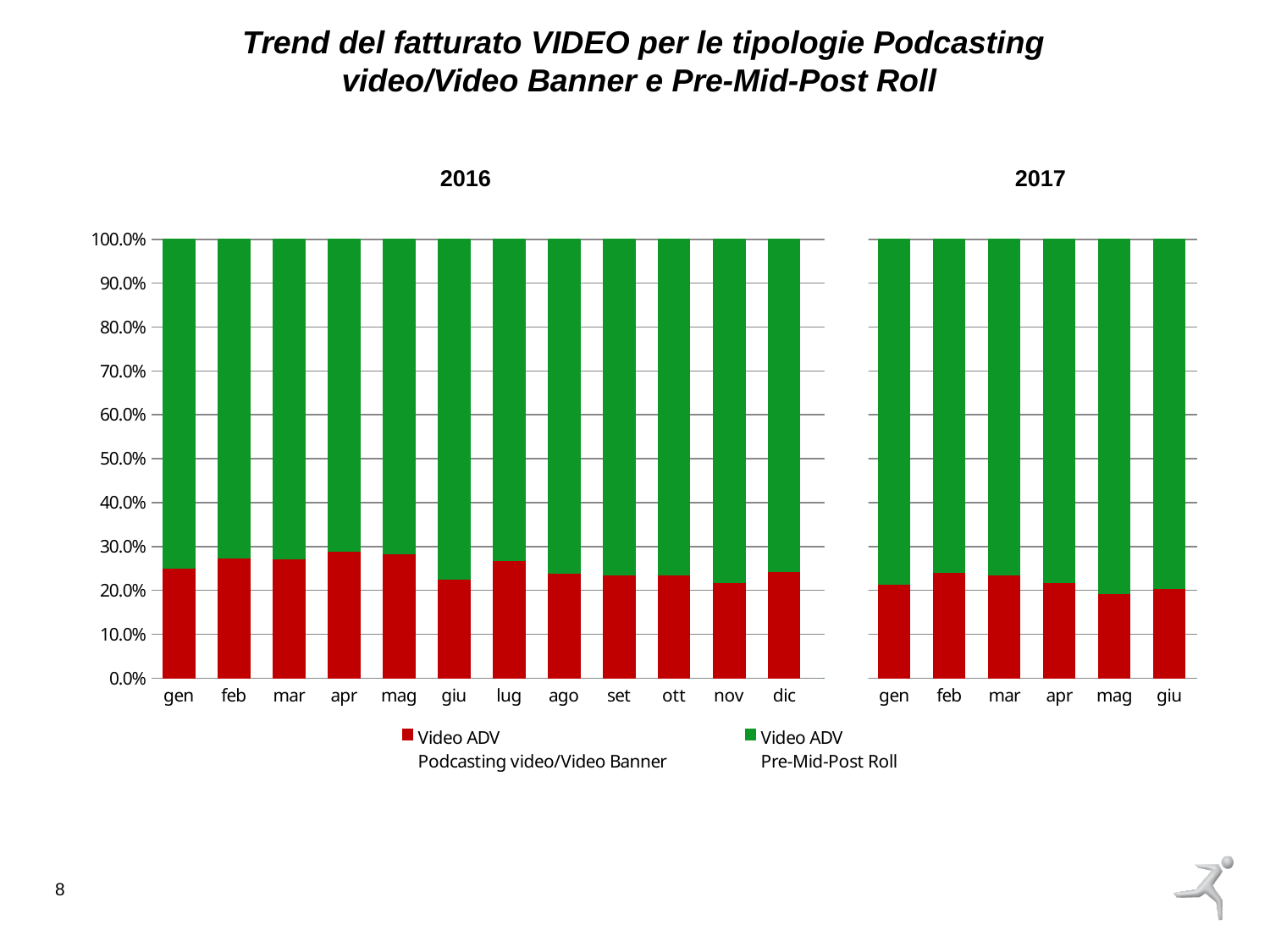
What is the total of the stacked bar for gen in the 2016 group? 100.0% How many months are plotted in the 2016 group? 12 In the 2016 group, is the value for Video ADV Pre-Mid-Post Roll in gen greater or less than 50.0%? greater In the 2017 group, which is larger for Video ADV Podcasting video/Video Banner: feb or mag? feb How many series does the legend list? 2 In the 2016 group, is the value for Video ADV Podcasting video/Video Banner in apr greater or less than 20.0%? greater In the 2016 group, which is larger for Video ADV Podcasting video/Video Banner: apr or giu? apr What kind of chart is shown on the slide? Stacked bar chart How many months are plotted in the 2017 group? 6 In the 2016 group, is the value for Video ADV Podcasting video/Video Banner in giu greater or less than 30.0%? less Which colour represents Video ADV Pre-Mid-Post Roll in the chart? Green